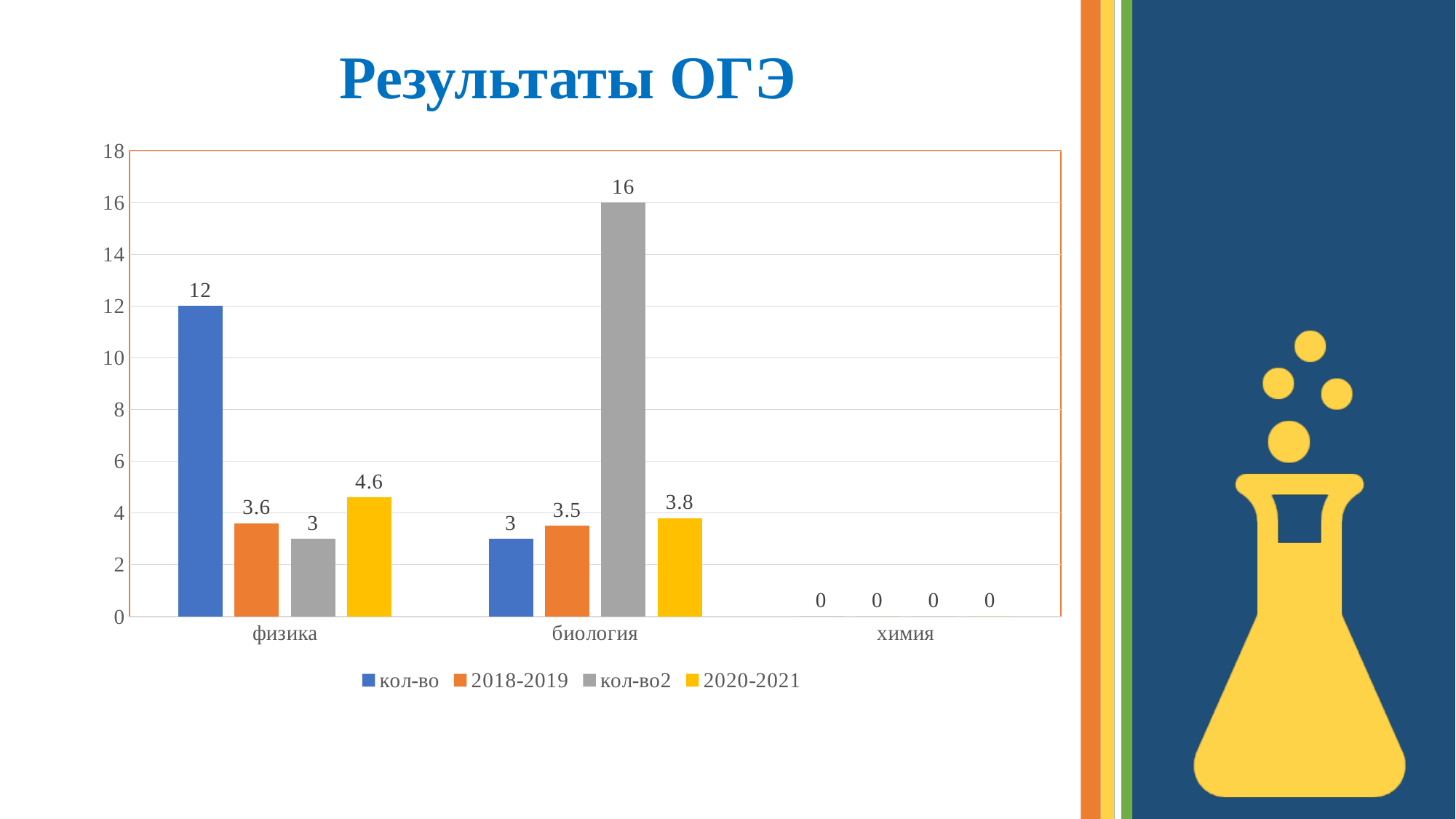
What is the value of the 2020-2021 series for биология? 3.8 What is the value of the кол-во2 series for биология? 16 How many categories are shown on the x axis? 3 Which category has the highest value in the кол-во2 series? биология Which is larger: the 2020-2021 value for физика or the 2020-2021 value for биология? физика What kind of chart is shown on the slide? bar chart What is the difference between the кол-во2 value for биология and the кол-во2 value for физика? 13 How many series does the legend list? 4 What is the value of the 2018-2019 series for физика? 3.6 What is the title of the slide? Результаты ОГЭ What is the value of the кол-во series for физика? 12 Which category has the highest value in the кол-во series? физика